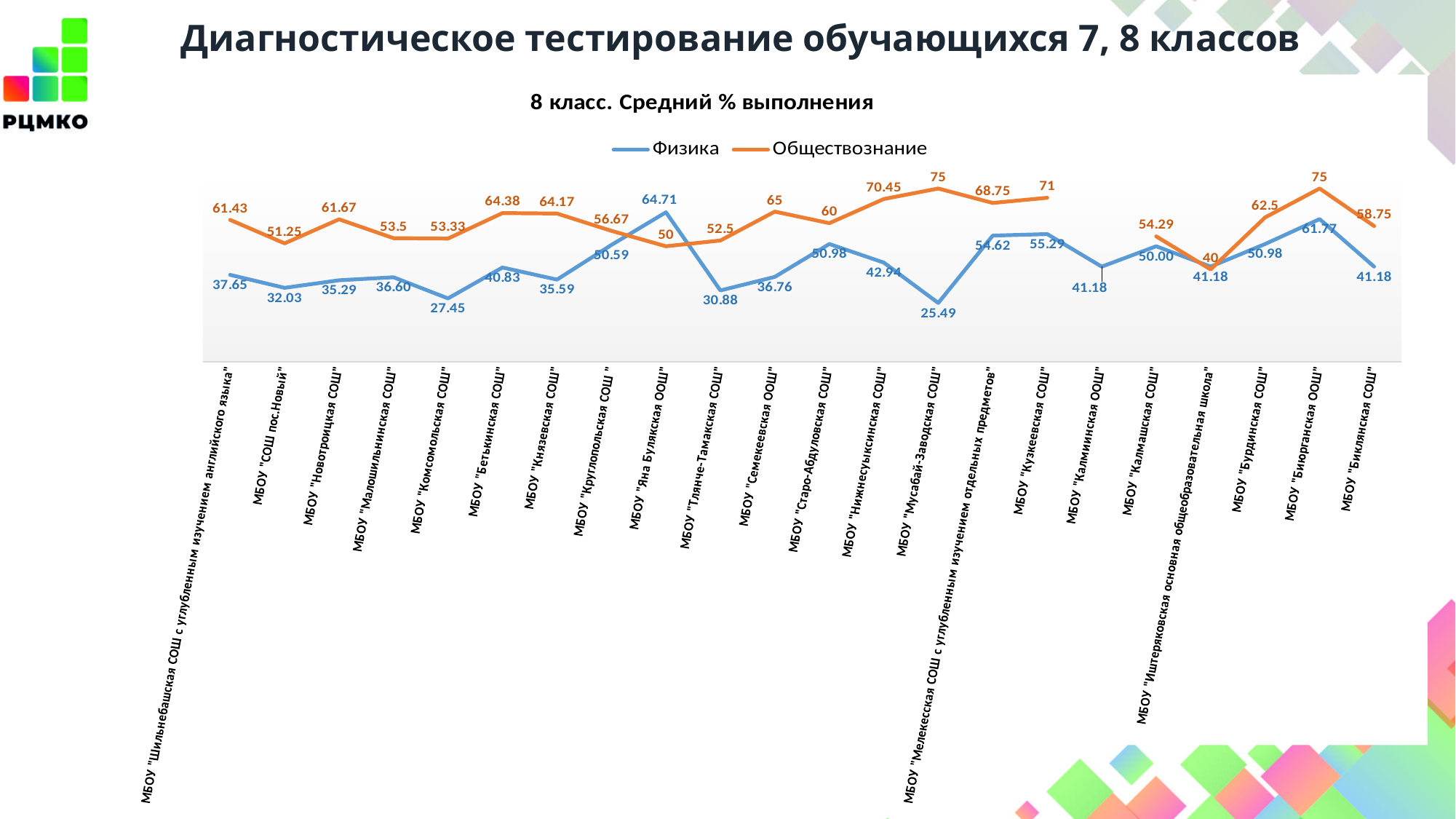
Which school has the highest Физика value? МБОУ "Яна Булякская ООШ" What is the difference between the Обществознание and Физика values for МБОУ "Мусабай-Заводская СОШ"? 49.51 What is the Физика value for МБОУ "Комсомольская СОШ"? 27.45 What type of chart is shown on the slide? line chart What is the Физика value for МБОУ "Биюрганская ООШ"? 61.77 How many series does the legend list? 2 Which school has the lowest Физика value? МБОУ "Мусабай-Заводская СОШ" What is the title of the chart? 8 класс. Средний % выполнения How many schools are plotted along the x axis? 22 What is the Обществознание value for МБОУ "Нижнесуыксинская СОШ"? 70.45 For МБОУ "Яна Буляксая ООШ", which is larger: the Физика value or the Обществознание value? Физика Which school has the lowest Обществознание value? МБОУ "Иштеряковская основная общеобразовательная школа"